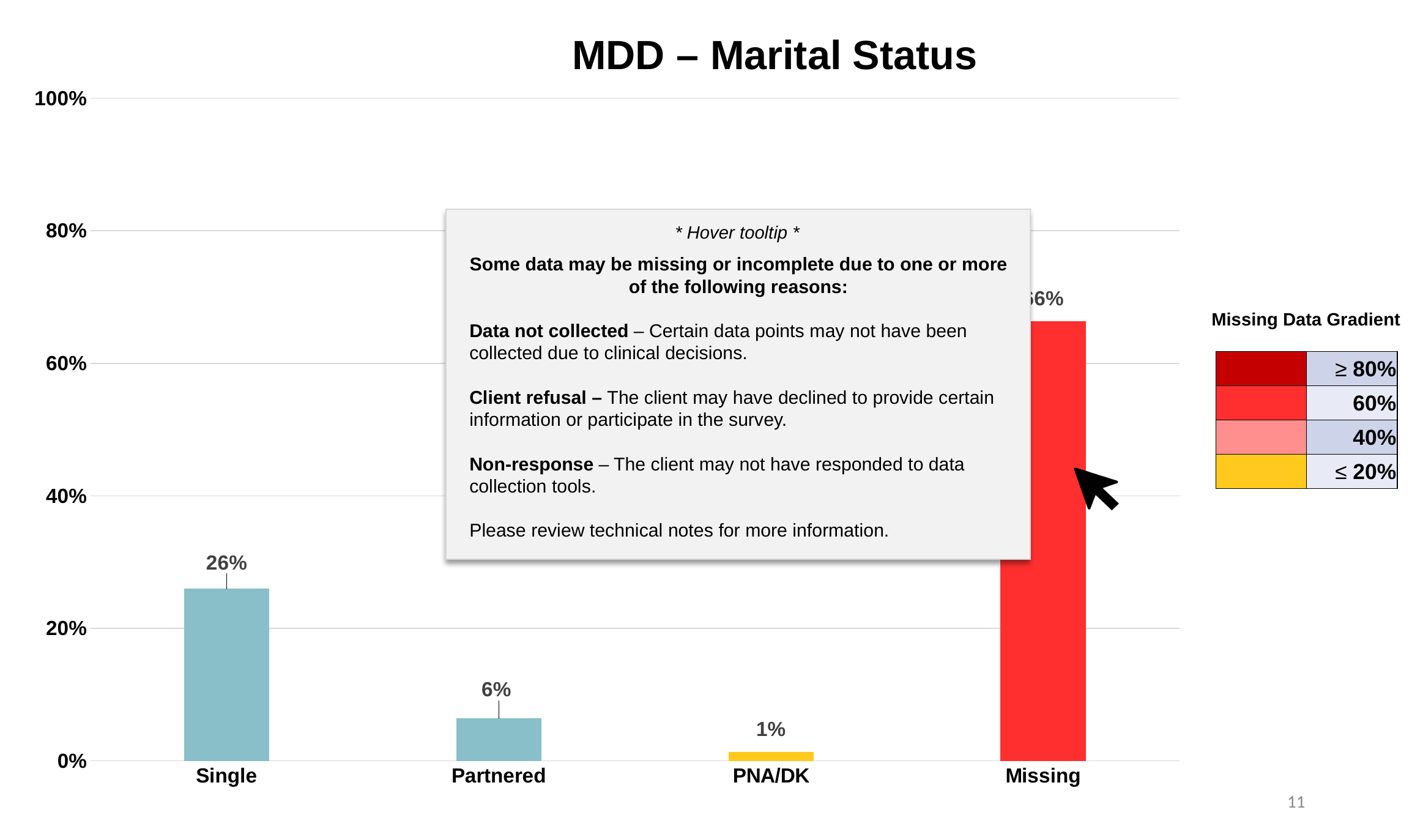
How many categories are shown on the x axis? 4 Which is larger, the value for Single or the value for Partnered? Single Is the value for Missing greater or less than 60%? greater What is the difference between the values for Partnered and PNA/DK? 5 percentage points What is the value for Single? 26% What kind of chart is shown on the slide? bar chart What is the difference between the values for Single and Partnered? 20 percentage points Which category has the highest value? Missing What is the value for Partnered? 6% What is the title of the chart? MDD – Marital Status What is the value for PNA/DK? 1% Which category has the lowest value? PNA/DK